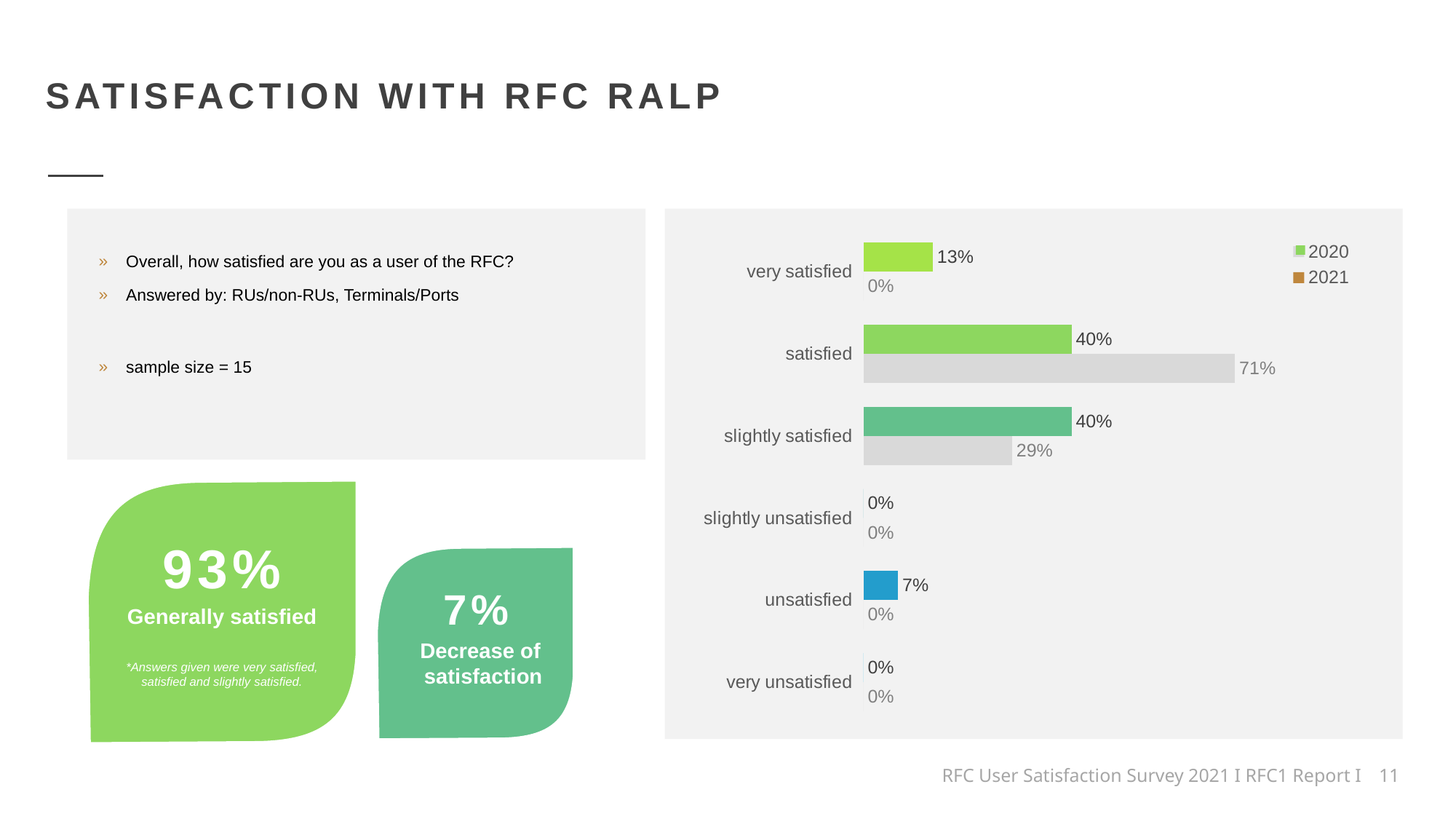
What is the difference between the two bars for 'satisfied' (71% and 40%)? 31% For 'slightly satisfied', which bar is larger: the upper (coloured) bar or the lower (grey) bar? the upper (coloured) bar Which two series are listed in the chart legend? 2020 and 2021 How many series does the chart legend list? 2 What is the value of both bars for 'very unsatisfied'? 0% How many satisfaction categories are shown on the chart? 6 What is the value of the upper (coloured) bar for 'unsatisfied'? 7% What is the value of the lower (grey) bar for 'slightly satisfied'? 29% What is the value of the upper (coloured) bar for 'very satisfied'? 13% Which category has the highest value among the lower (grey) bars? satisfied What type of chart is shown on the right of the slide? bar chart What is the value of the lower (grey) bar for 'satisfied'? 71%